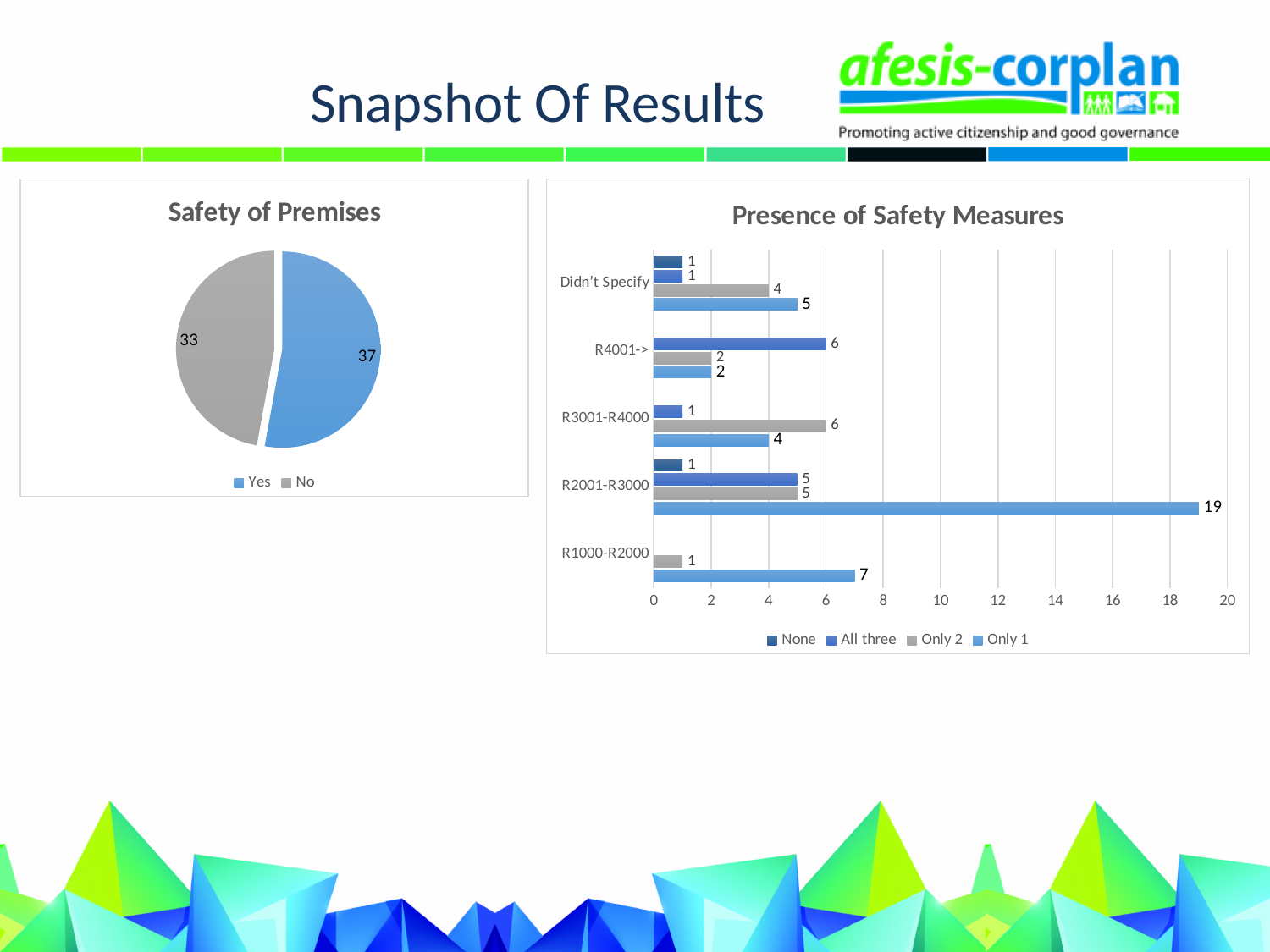
In the Safety of Premises chart, what is the value for No? 33 In the Safety of Premises chart, what is the difference between the Yes and No values? 4 In the Presence of Safety Measures chart, what is the All three value for R4001->? 6 What kind of chart is Presence of Safety Measures? Bar chart What kind of chart is Safety of Premises? Pie chart In the Safety of Premises chart, what is the value for Yes? 37 In the Presence of Safety Measures chart, how many categories are shown on the vertical axis? 5 In the Presence of Safety Measures chart, what is the difference between the Only 1 values for R2001-R3000 and R1000-R2000? 12 In the Presence of Safety Measures chart, what is the Only 1 value for R2001-R3000? 19 In the Presence of Safety Measures chart, which category has the highest Only 1 value? R2001-R3000 In the Presence of Safety Measures chart, what is the Only 2 value for R3001-R4000? 6 In the Presence of Safety Measures chart, how many series does the legend list? 4